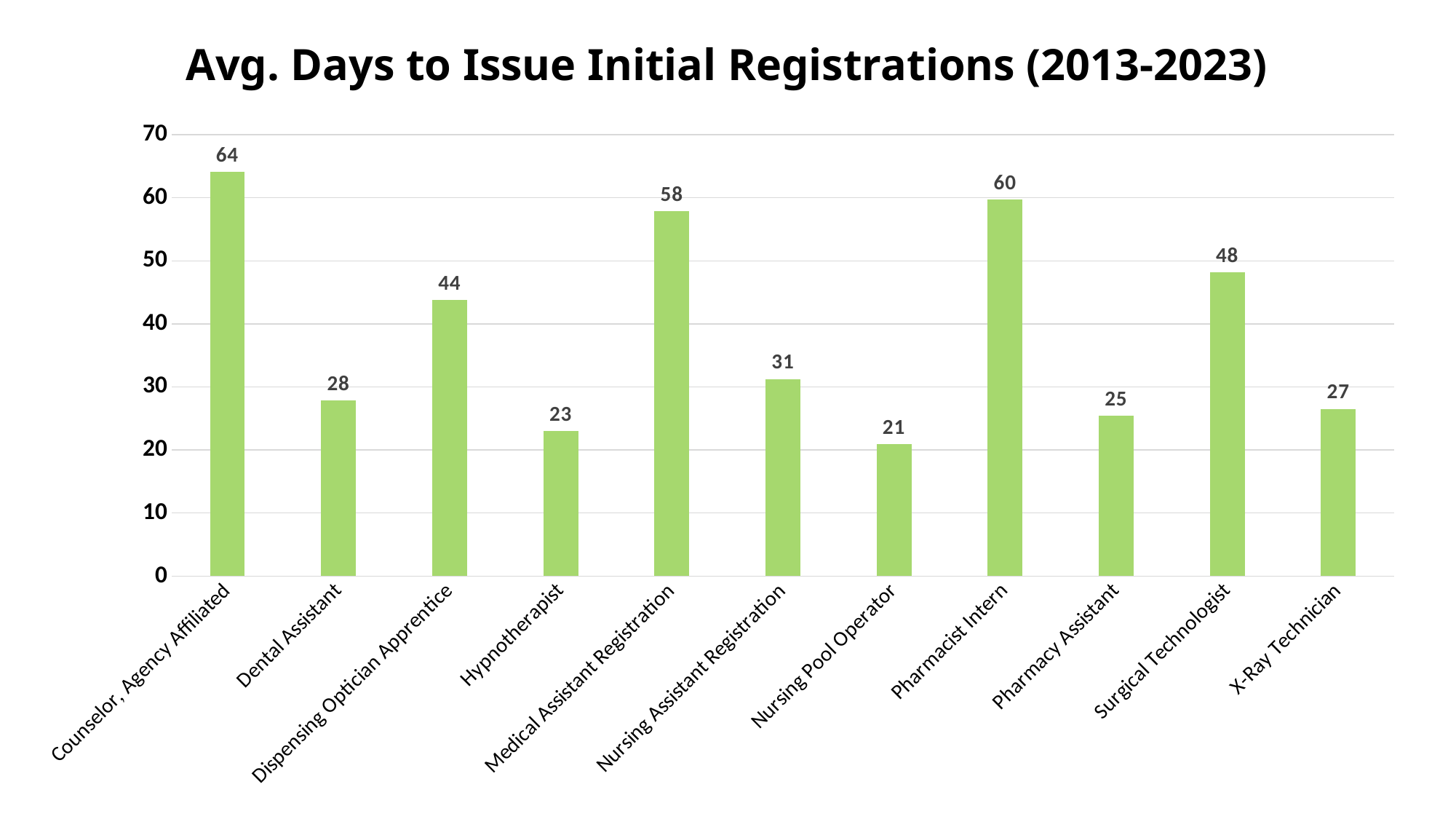
What is the title of the chart? Avg. Days to Issue Initial Registrations (2013-2023) Is the value for Hypnotherapist greater or less than 30? less What is the average number of days to issue initial registrations for Pharmacist Intern? 60 How many categories are shown on the x axis? 11 Which is larger, the value for Surgical Technologist or the value for Dispensing Optician Apprentice? Surgical Technologist What colour are the bars in the chart? green What is the difference between the values for Medical Assistant Registration and Dental Assistant? 30 What is the value shown for Nursing Assistant Registration? 31 Which category has the highest average days to issue initial registrations? Counselor, Agency Affiliated What kind of chart is shown on the slide? bar chart Which category has the lowest average days to issue initial registrations? Nursing Pool Operator What is the value shown for X-Ray Technician? 27